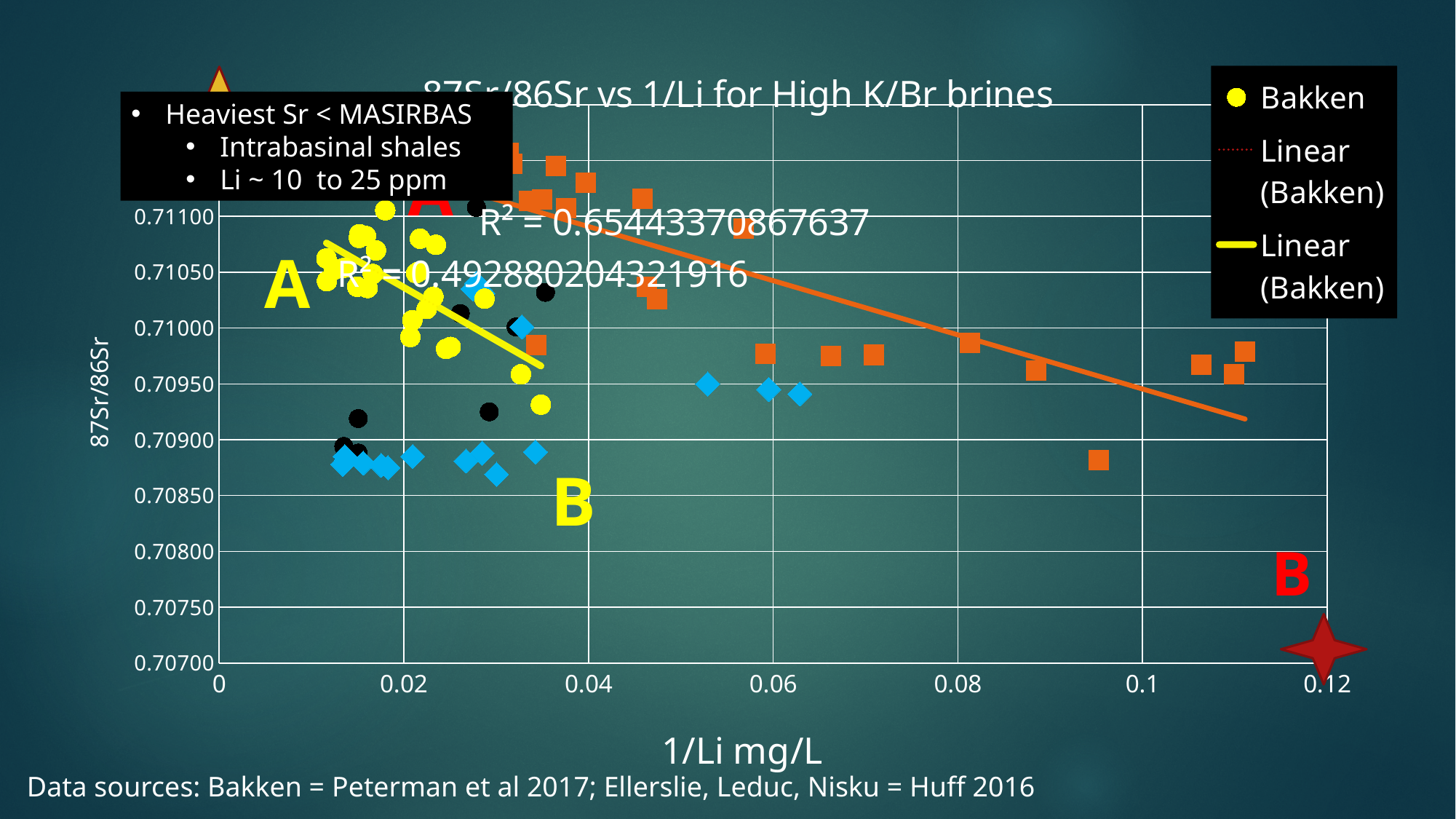
Does the orange linear trend line rise or fall as 1/Li increases along the x axis? fall What is the label of the x axis? 1/Li mg/L What kind of chart is shown on the slide? scatter chart What is the highest value shown on the x axis? 0.12 Does the yellow linear trend line rise or fall as 1/Li increases along the x axis? fall What is the larger R² value printed on the chart? 0.65443370867637 Is the 87Sr/86Sr value of the orange square plotted at about 1/Li = 0.08 greater or less than 0.70950? greater What is the smaller R² value printed on the chart? 0.492880204321916 What is the title of the chart? 87Sr/86Sr vs 1/Li for High K/Br brines How many entries does the chart legend list? 3 Is the 87Sr/86Sr value of the orange square plotted at about 1/Li = 0.095 greater or less than 0.70950? less Which of the two printed R² values is larger, 0.65443370867637 or 0.492880204321916? 0.65443370867637